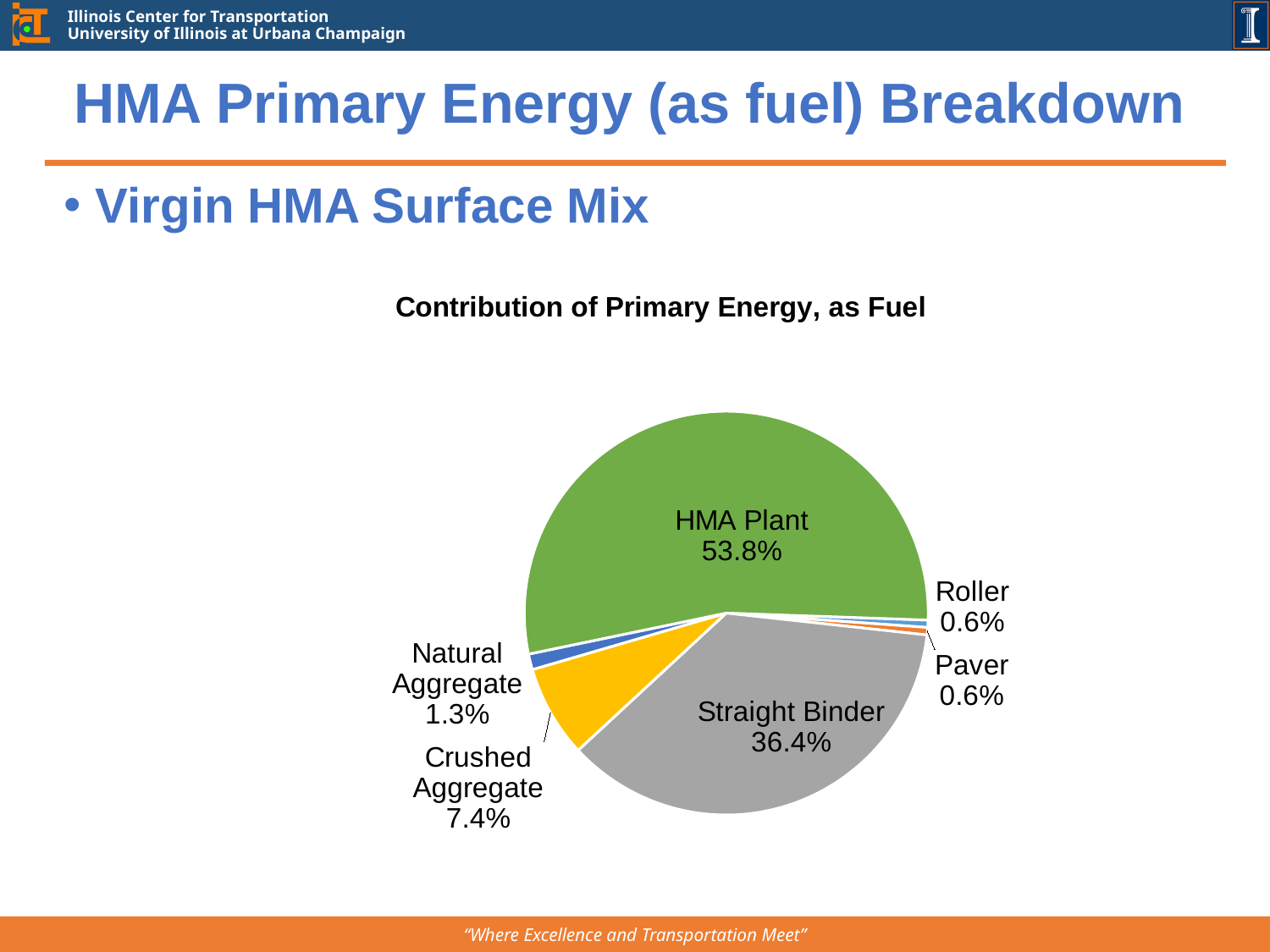
How many slices are labelled in the pie chart? 6 What is the difference in percentage points between HMA Plant and Straight Binder? 17.4 What share is shown for the Roller? 0.6% What is the difference in percentage points between Crushed Aggregate and Natural Aggregate? 6.1 What share of primary energy as fuel does the HMA Plant account for? 53.8% What type of chart is shown on the slide? Pie chart What percentage is shown for Straight Binder? 36.4% What is the value shown for Crushed Aggregate? 7.4% What percentage is shown for Natural Aggregate? 1.3% Which category has the largest share of the pie? HMA Plant Which is larger, Crushed Aggregate or Natural Aggregate? Crushed Aggregate What is the title of the chart? Contribution of Primary Energy, as Fuel